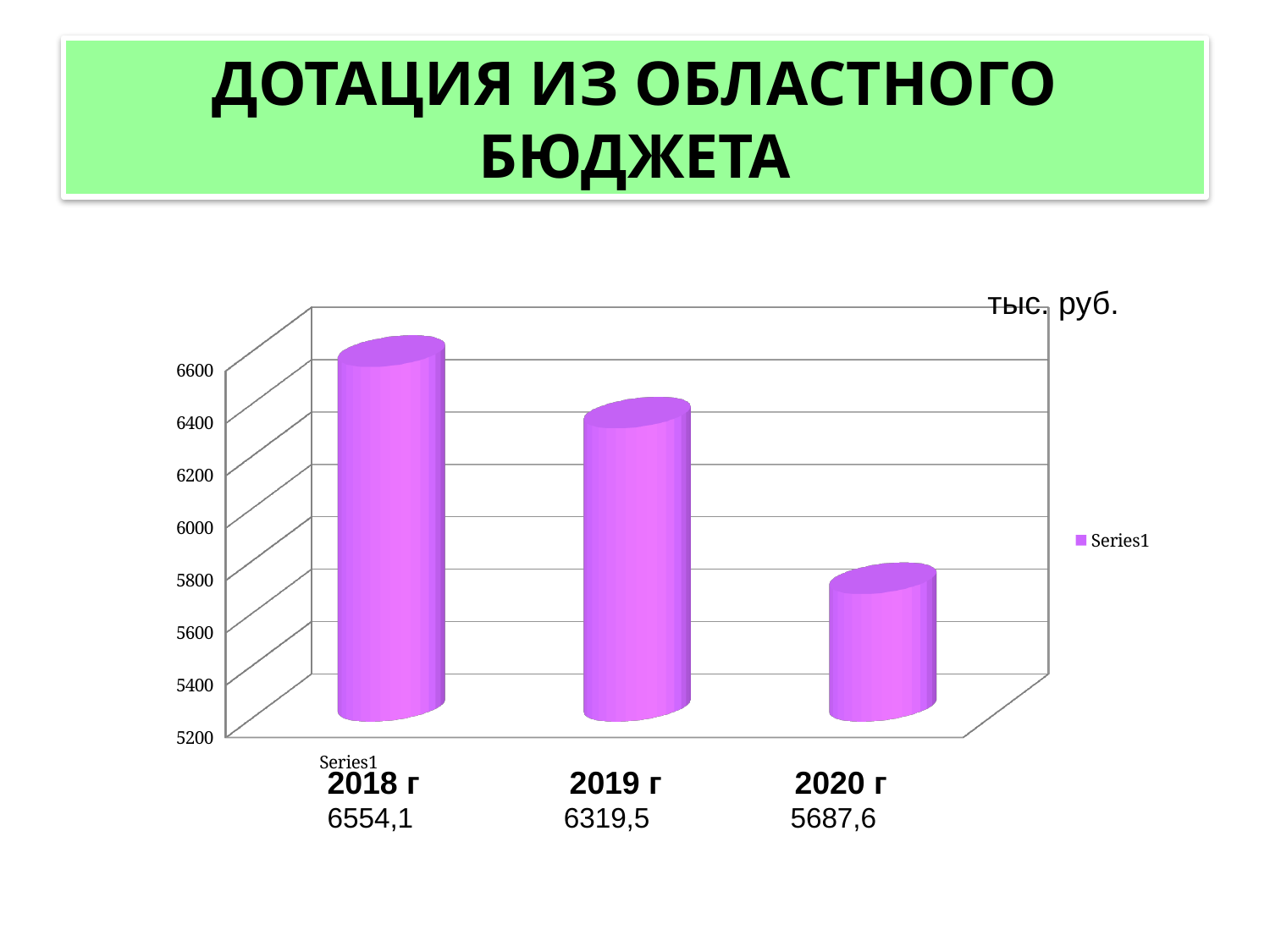
What is the value for 2018 г? 6554,1 Which year has the highest value? 2018 г What is the value for 2020 г? 5687,6 What is the difference between the values for 2018 г and 2019 г? 234,6 Which year has the lowest value? 2020 г Is the value for 2020 г greater or less than 6000? less What kind of chart is shown on the slide? bar chart Which is larger, the value for 2019 г or the value for 2020 г? 2019 г How many years are shown on the chart? 3 What is the difference between the values for 2019 г and 2020 г? 631,9 What is the value for 2019 г? 6319,5 Do the values rise or fall from 2018 г to 2020 г? fall